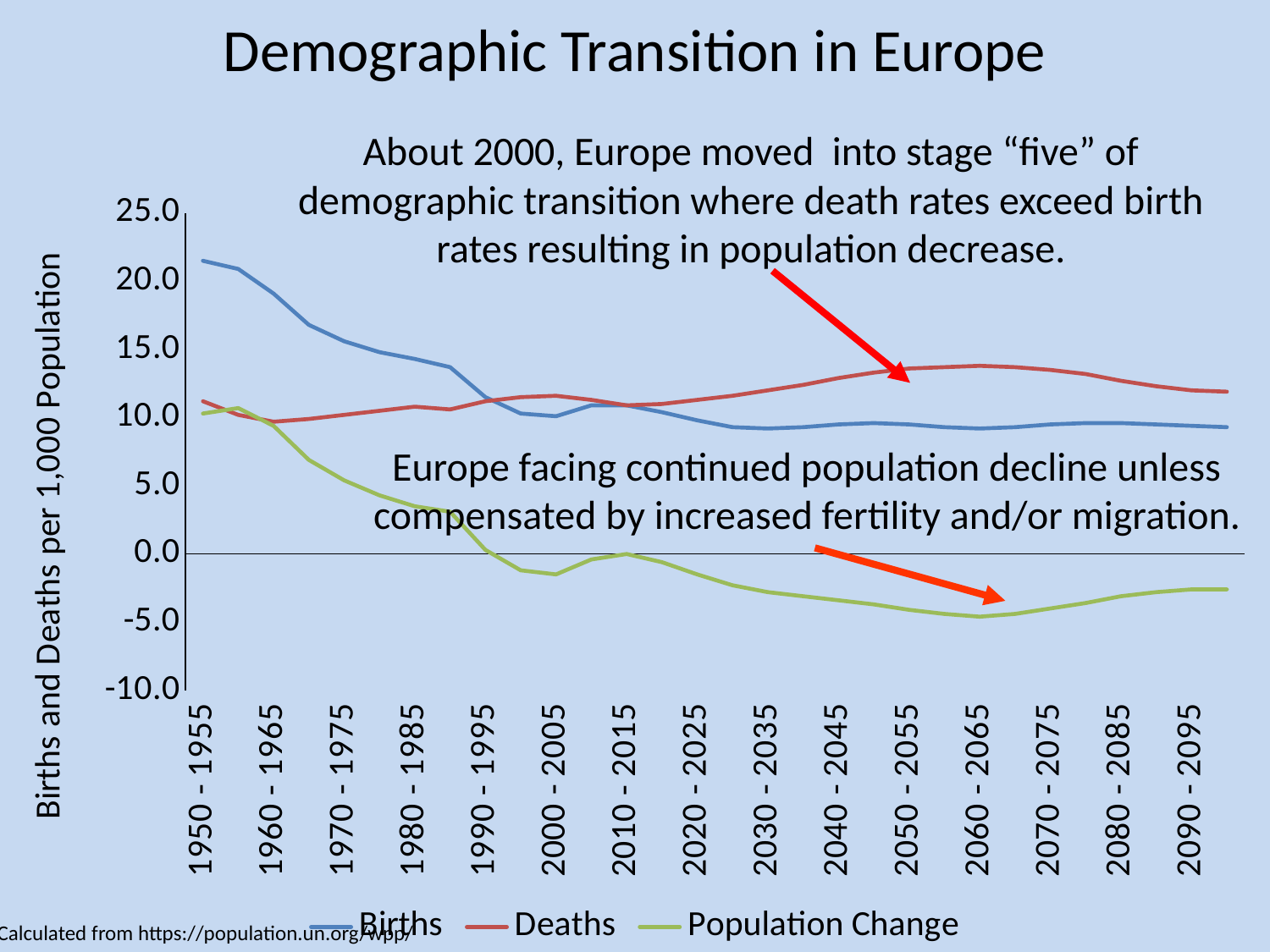
What kind of chart is shown on the slide? line chart Is the Deaths value for 2060 - 2065 greater or less than 10.0? greater Which series has the higher value in 2060 - 2065, Births or Deaths? Deaths Is the Births value for 1950 - 1955 greater or less than 20.0? greater How many series does the legend list? 3 Which series has the lowest value in 2060 - 2065? Population Change What is the label on the vertical axis? Births and Deaths per 1,000 Population Which series has the higher value in 1950 - 1955, Births or Deaths? Births Does the Births line generally rise or fall from 1950 - 1955 to 2090 - 2095? fall Is the Population Change value for 2060 - 2065 greater or less than 0.0? less What is the title of the slide's chart? Demographic Transition in Europe